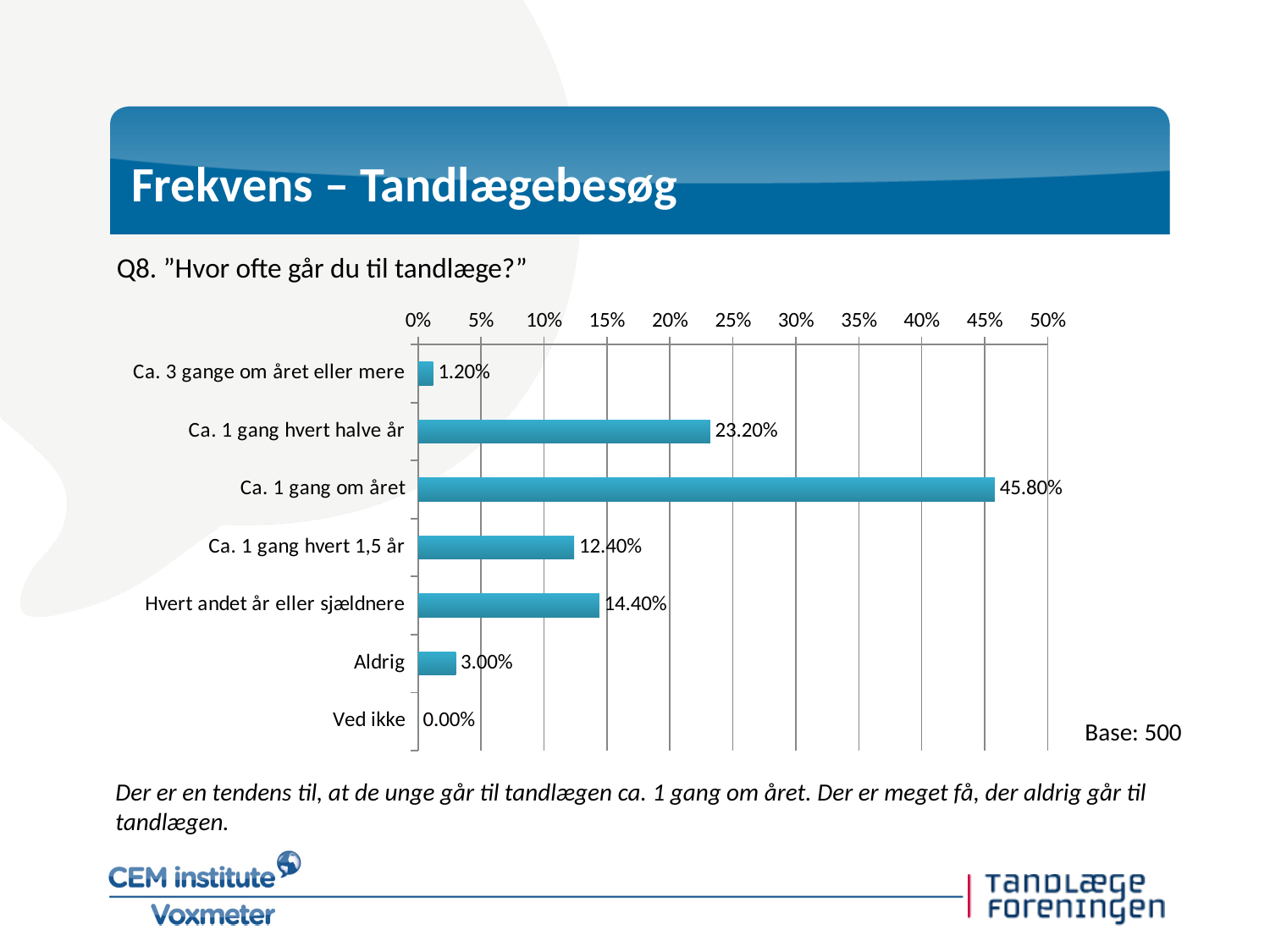
What kind of chart is shown on the slide? Bar chart Which category has the lowest value? Ved ikke Which category has the highest value? Ca. 1 gang om året What is the value for "Ca. 1 gang om året"? 45.80% What is the value for "Hvert andet år eller sjældnere"? 14.40% How many categories are shown in the chart? 7 Which is larger, "Hvert andet år eller sjældnere" or "Ca. 1 gang hvert 1,5 år"? Hvert andet år eller sjældnere What is the difference between "Ca. 1 gang om året" and "Ca. 1 gang hvert halve år"? 22.60% What is the question text shown above the chart? Q8. "Hvor ofte går du til tandlæge?" What is the value for "Aldrig"? 3.00% What is the value for "Ca. 1 gang hvert halve år"? 23.20% Is the value for "Ca. 1 gang hvert halve år" greater or less than 20%? greater